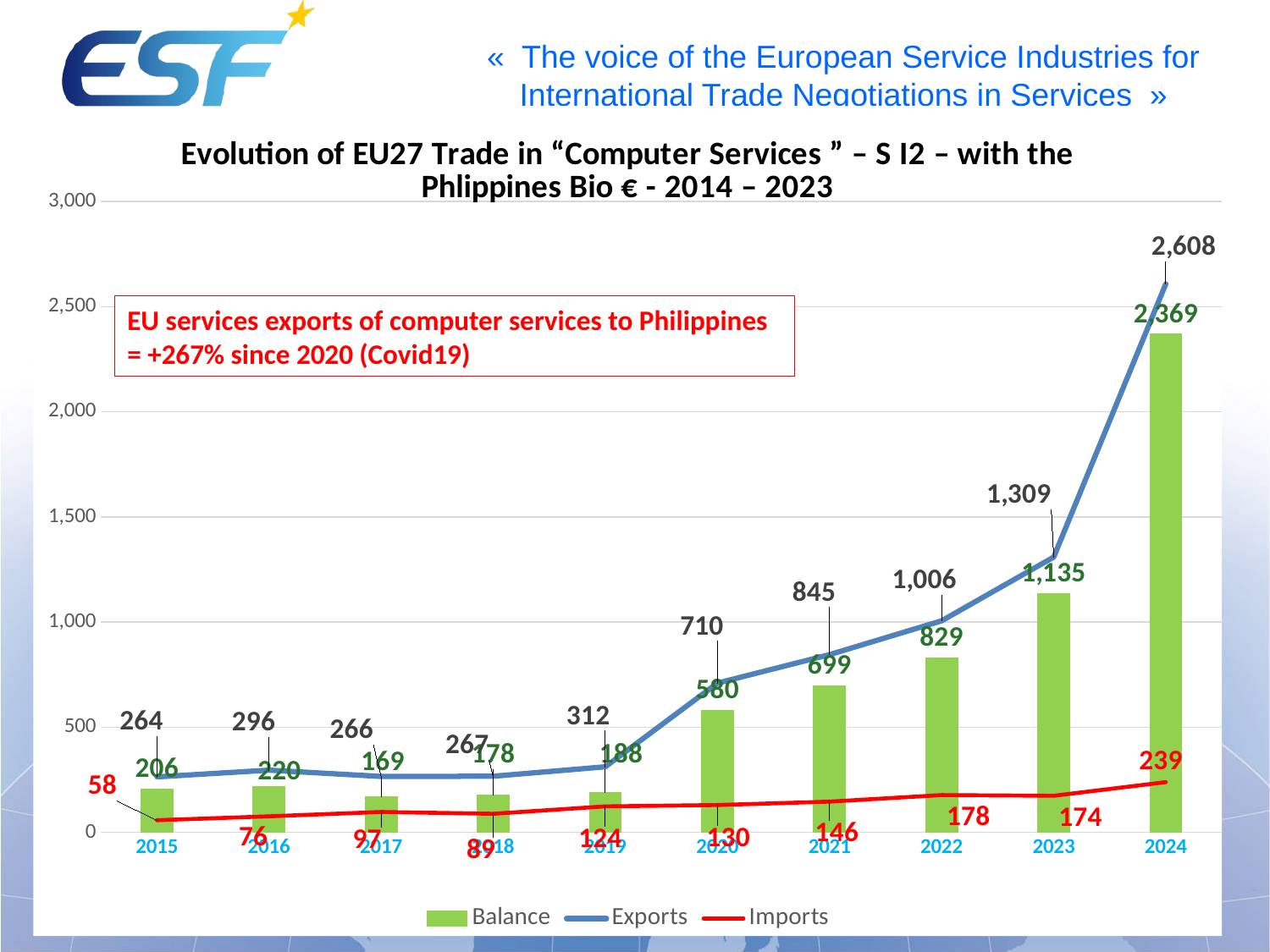
What is the value of Exports in 2020? 710 How many years are shown on the x axis? 10 What is the difference between Exports and Imports in 2023? 1,135 What is the value of Exports in 2024? 2,608 Does the Exports line generally rise or fall from 2019 to 2024? rise In which year is Exports highest? 2024 In which year is Imports lowest? 2015 What is the value of Balance in 2021? 699 Which is larger in 2022: Balance or Imports? Balance How many series does the legend list? 3 What is the value of Imports in 2015? 58 Which series is shown as green bars? Balance